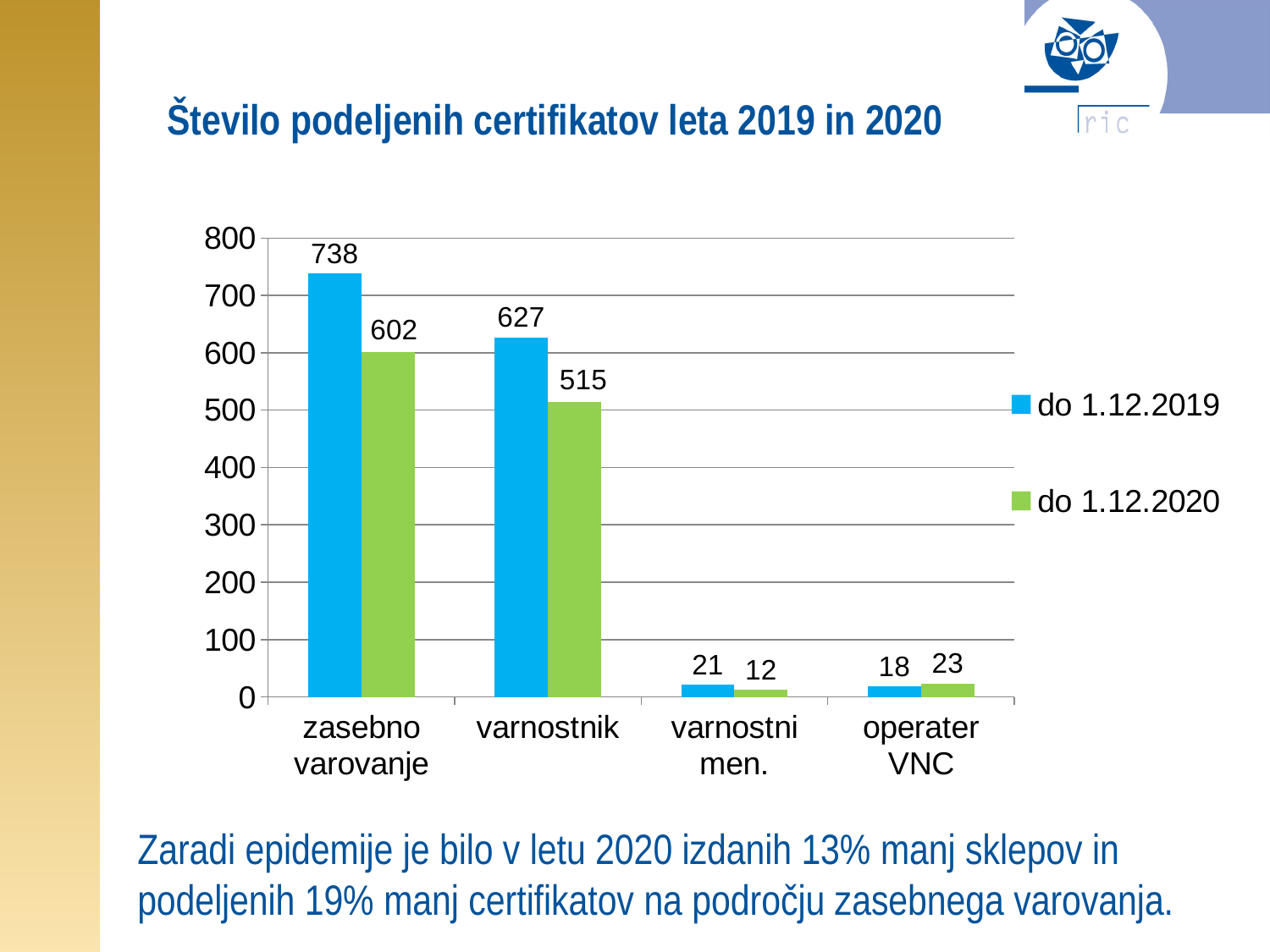
For operater VNC, which series has the larger value, do 1.12.2019 or do 1.12.2020? do 1.12.2020 What kind of chart is shown on the slide? bar chart What is the value for zasebno varovanje in the do 1.12.2019 series? 738 Which category has the lowest value in the do 1.12.2019 series? operater VNC What is the value for varnostnik in the do 1.12.2020 series? 515 Which category has the highest value in the do 1.12.2020 series? zasebno varovanje How many series does the legend list? 2 What is the title of the chart on the slide? Število podeljenih certifikatov leta 2019 in 2020 What is the difference between the do 1.12.2019 and do 1.12.2020 values for zasebno varovanje? 136 Is the do 1.12.2019 value for varnostnik greater or less than 600? greater What is the value for operater VNC in the do 1.12.2019 series? 18 How many categories are shown on the x axis? 4